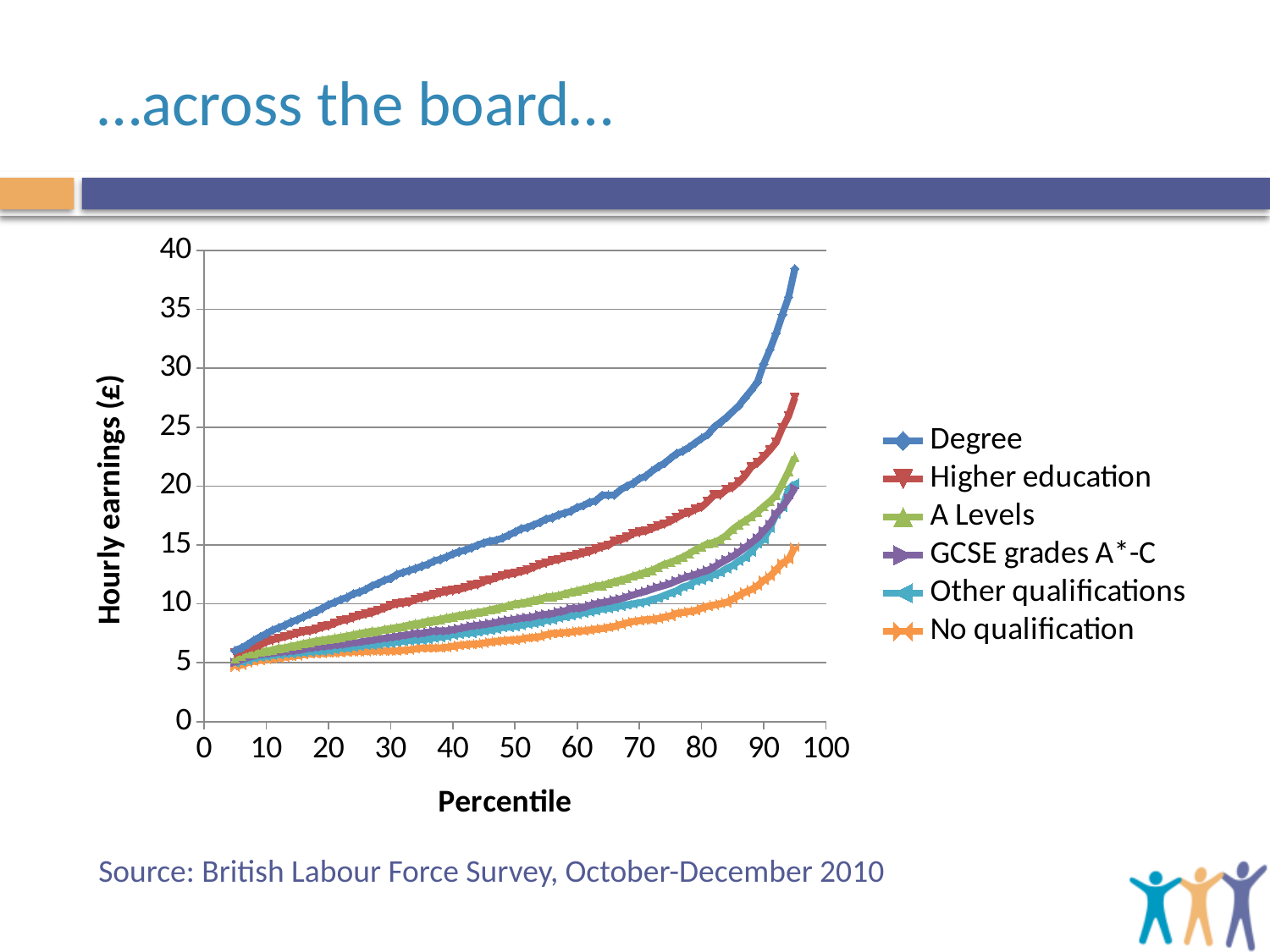
Is the value for Degree at the 30th percentile greater or less than 10? greater Which series has the highest hourly earnings at the 95th percentile? Degree At the 60th percentile, which is larger: Higher education or A Levels? Higher education What is the label of the vertical axis? Hourly earnings (£) What kind of chart is shown on the slide? line chart At the 80th percentile, which is larger: Degree or No qualification? Degree Is the value for Higher education at the 95th percentile greater or less than 25? greater Is the value for Degree at the 95th percentile greater or less than 35? greater Which series has the lowest hourly earnings across the percentiles shown? No qualification Do hourly earnings for the Degree series rise or fall as the percentile increases? rise How many series does the legend list? 6